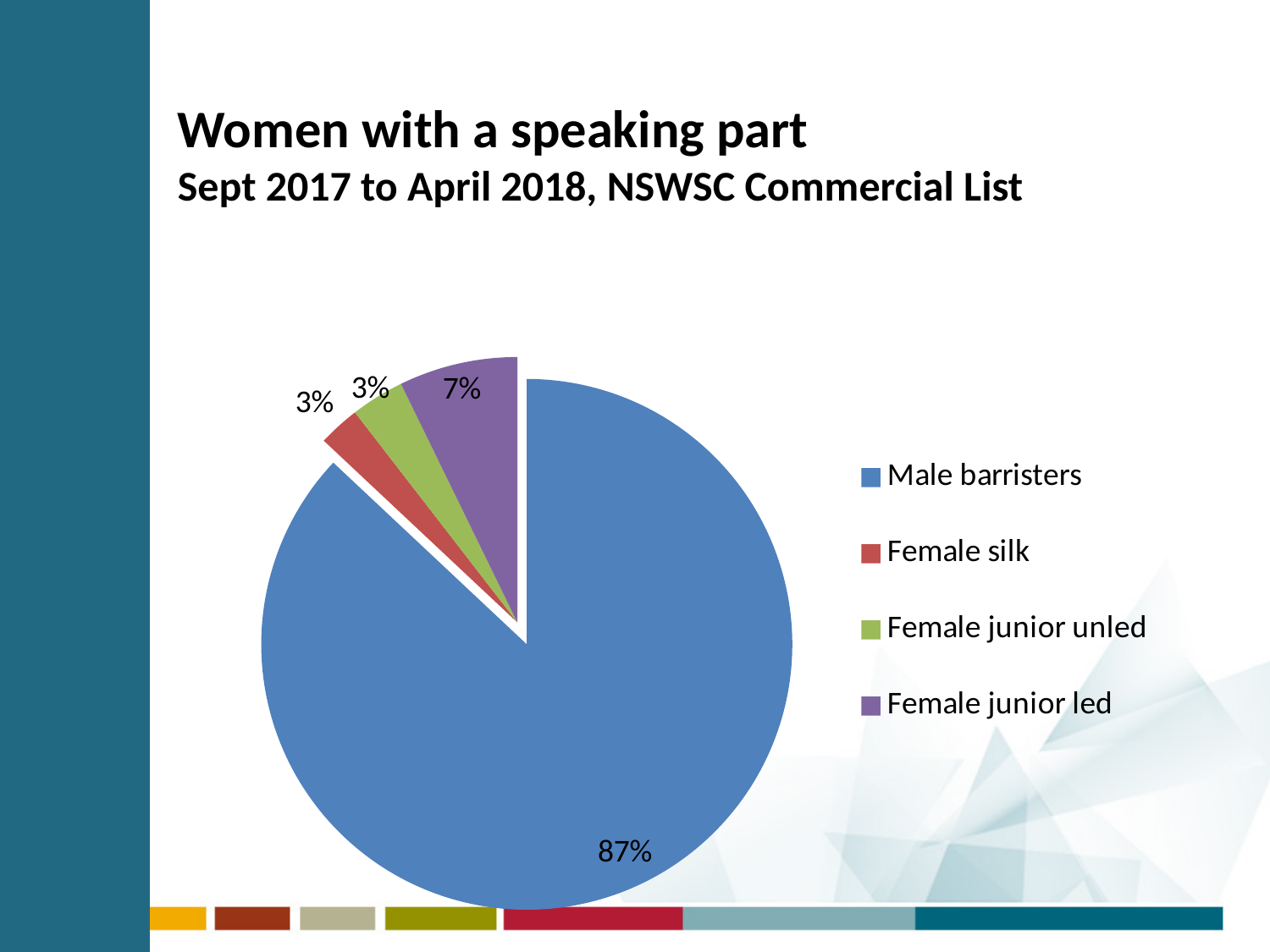
What is the combined share of the three female categories (Female silk, Female junior unled and Female junior led)? 13% What kind of chart is shown on the slide? pie chart How many percentage points larger is the Male barristers share than the Female junior led share? 80 What share of the pie is Female junior unled? 3% How many categories does the legend list? 4 Which category has the largest share of the pie? Male barristers Which colour represents Female junior led in the pie chart? purple Which is larger, the share for Female junior led or the share for Female silk? Female junior led What share of the pie is Female junior led? 7% What is the title of the slide containing the chart? Women with a speaking part What share of the pie is Male barristers? 87% What share of the pie is Female silk? 3%